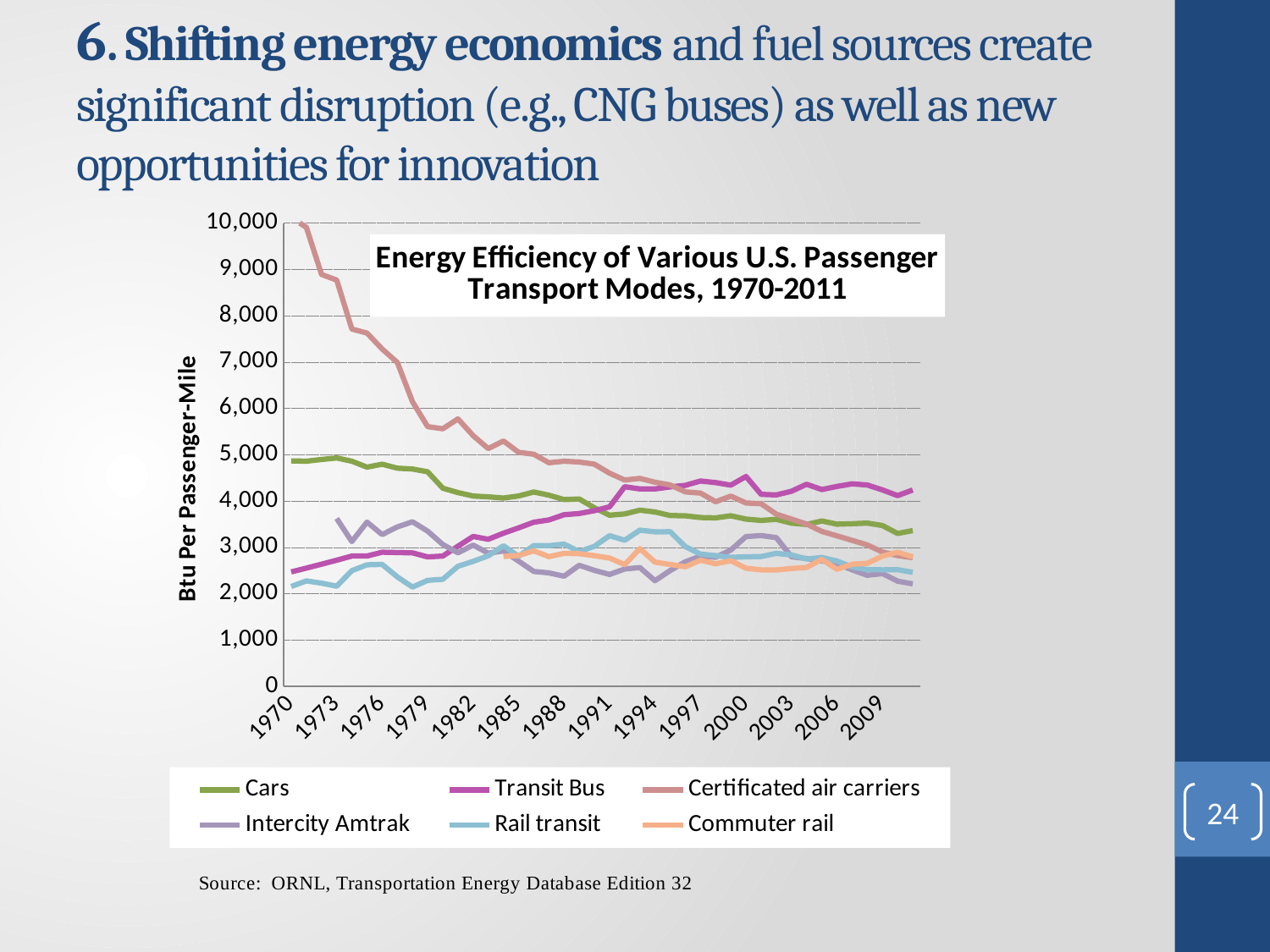
Which series has the highest value in 1970? Certificated air carriers How many series does the legend list? 6 What is the label on the vertical axis of the chart? Btu Per Passenger-Mile Is the value for Transit Bus in 1970 greater or less than 3,000? less Is the value for Certificated air carriers in 1970 greater or less than 9,000? greater Does the Cars line rise or fall overall from 1970 to 2011? Fall In 1970, which is larger: the value for Cars or the value for Transit Bus? Cars What is the title of the chart? Energy Efficiency of Various U.S. Passenger Transport Modes, 1970-2011 Does the Transit Bus line rise or fall overall from 1970 to 2011? Rise Does the Certificated air carriers line rise or fall from 1970 to 2011? Fall Which series has the highest value at the right end of the chart (2011)? Transit Bus What kind of chart is shown on the slide? Line chart